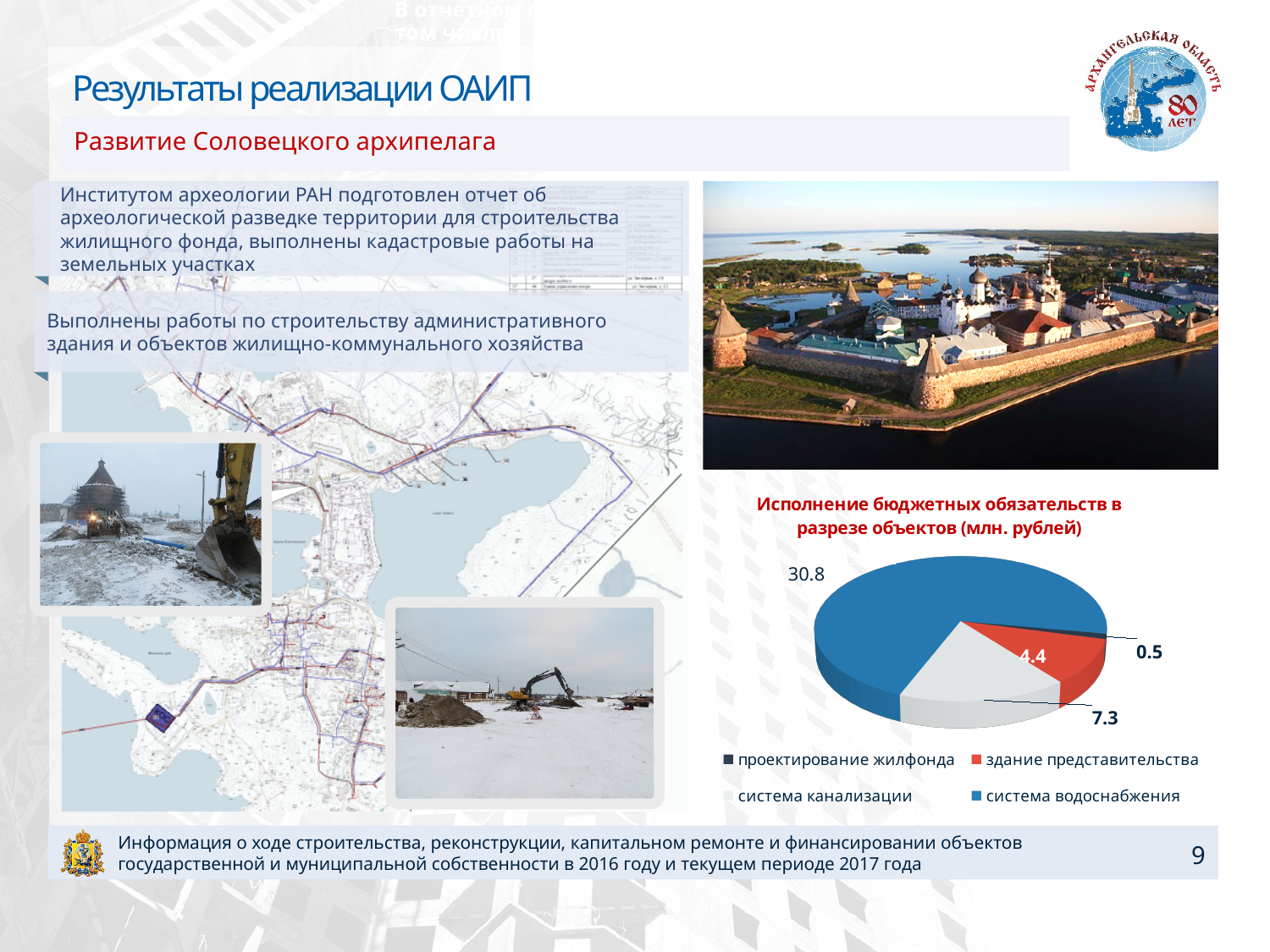
Which category has the smallest slice in the pie chart? проектирование жилфонда What is the title of the pie chart? Исполнение бюджетных обязательств в разрезе объектов (млн. рублей) What is the value for система канализации in the pie chart? 7.3 How many slices does the pie chart have? 4 What is the value for система водоснабжения in the pie chart? 30.8 What is the value for здание представительства in the pie chart? 4.4 What is the value for проектирование жилфонда in the pie chart? 0.5 What is the difference between the values for система водоснабжения and система канализации? 23.5 Which is larger, the value for здание представительства or the value for система канализации? система канализации What kind of chart is shown on the slide? pie chart What is the total of all values shown in the pie chart? 43.0 Which category has the largest slice in the pie chart? система водоснабжения